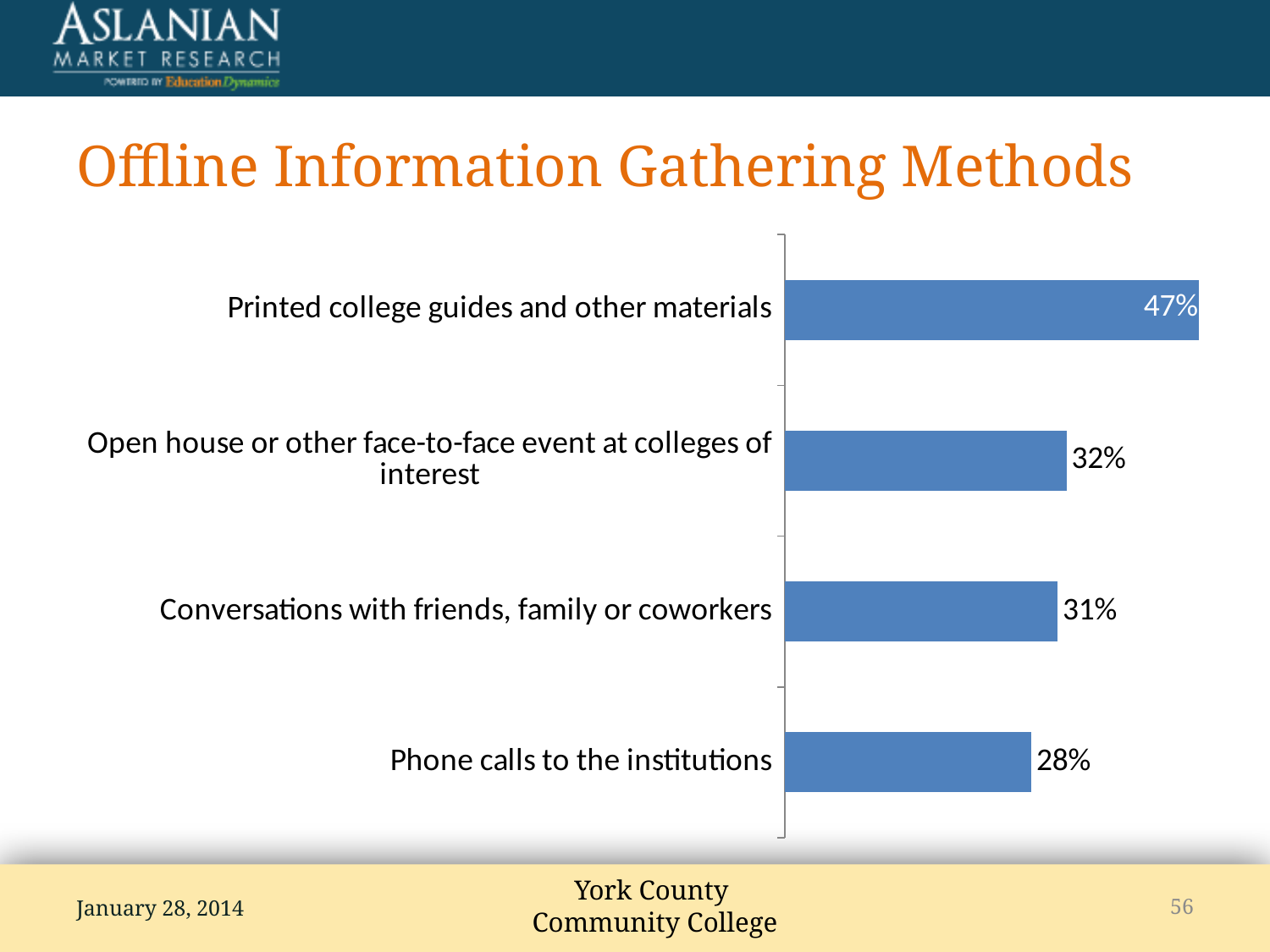
What is the value for Conversations with friends, family or coworkers? 31% How many categories are shown in the chart? 4 What is the title of the slide containing the chart? Offline Information Gathering Methods What is the difference between the values for Printed college guides and other materials and Phone calls to the institutions? 19% Which is larger: the value for Printed college guides and other materials or the value for Open house or other face-to-face event at colleges of interest? Printed college guides and other materials What is the value for Printed college guides and other materials? 47% What is the difference between the values for Open house or other face-to-face event at colleges of interest and Conversations with friends, family or coworkers? 1% Which category has the highest value? Printed college guides and other materials What is the value for Open house or other face-to-face event at colleges of interest? 32% Which category has the lowest value? Phone calls to the institutions What kind of chart is shown on the slide? Bar chart What is the value for Phone calls to the institutions? 28%